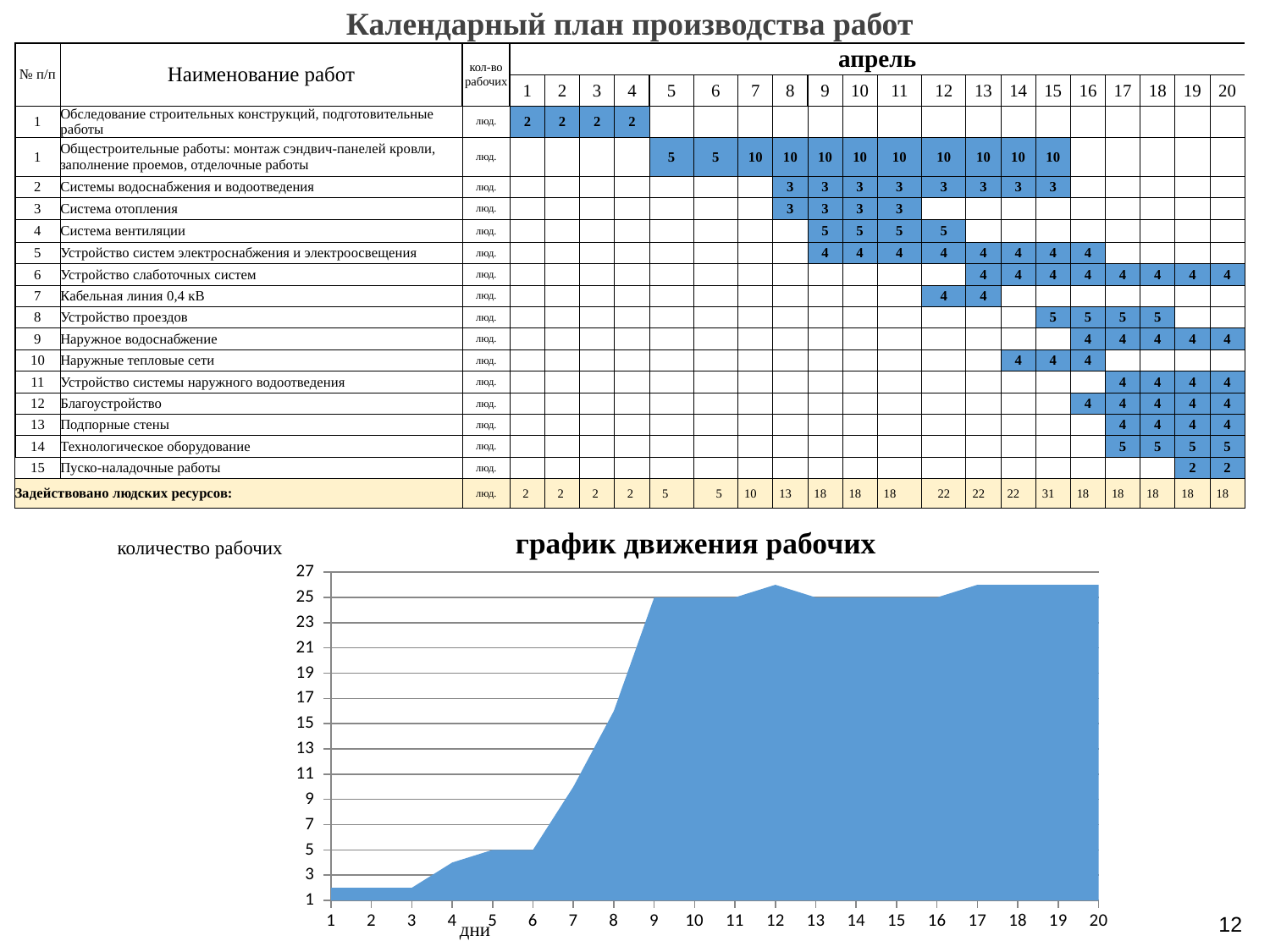
In the chart "график движения рабочих", is the value for day 9 greater or less than 21? greater In the chart "график движения рабочих", do the values rise or fall from day 1 to day 9? rise How many days are plotted along the x axis of the chart "график движения рабочих"? 20 In the chart "график движения рабочих", is the value for day 15 greater or less than 19? greater In the chart "график движения рабочих", which day has the larger value, day 3 or day 9? day 9 What is the title of the chart at the bottom of the slide? график движения рабочих In the chart "график движения рабочих", which day has the larger value, day 6 or day 8? day 8 In the chart "график движения рабочих", is the value for day 5 greater or less than 9? less What label is shown on the x axis of the chart "график движения рабочих"? дни What kind of chart is "график движения рабочих"? area chart